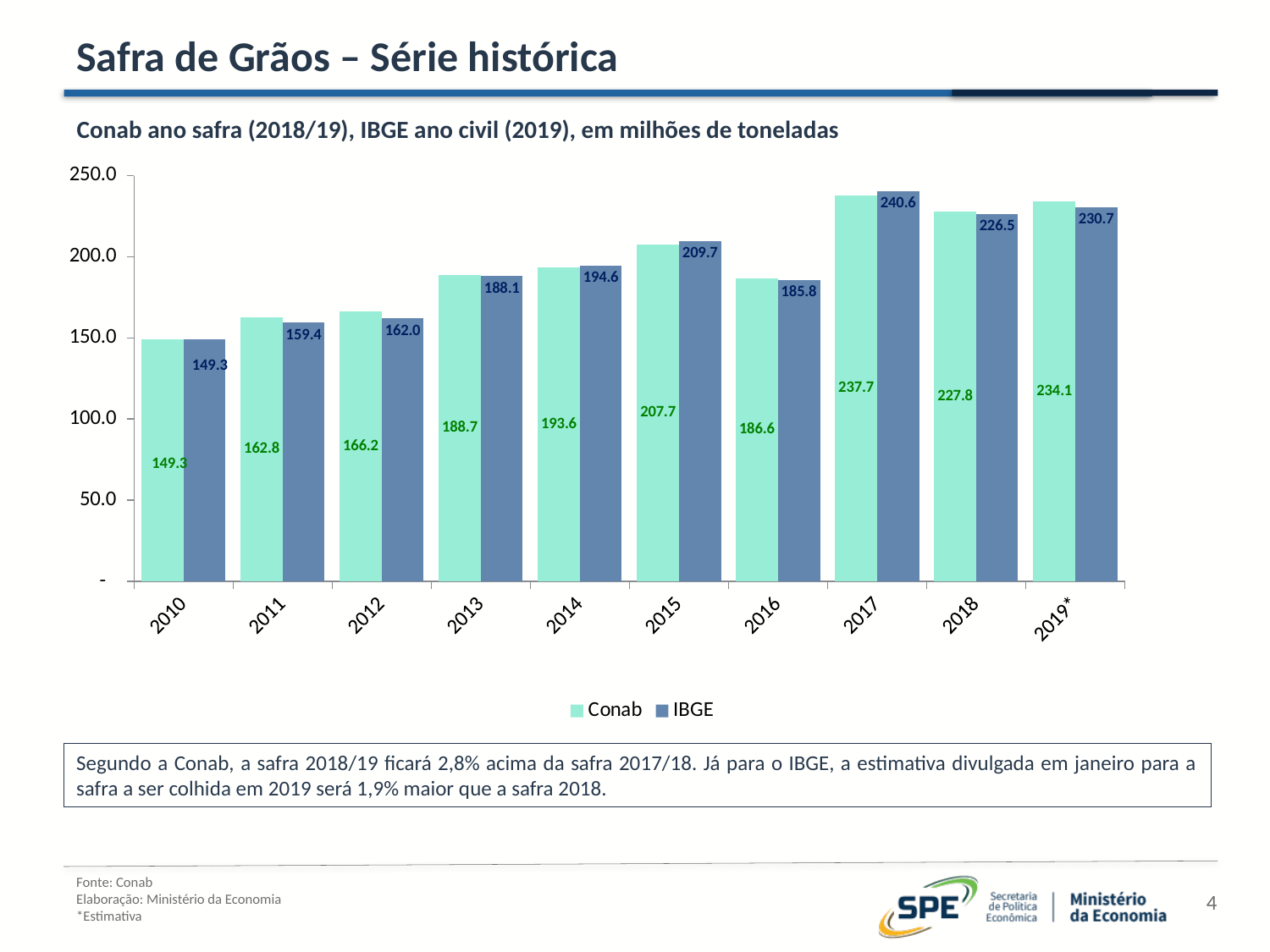
Which is larger, the Conab value for 2018 or the IBGE value for 2018? Conab (227.8) Is the IBGE value for 2013 greater or less than 150.0? greater What kind of chart is shown on the slide? Bar chart How many series does the legend list? 2 What is the IBGE value for 2015? 209.7 Which year has the highest IBGE value? 2017 What is the Conab value for 2017? 237.7 Which series is shown in dark blue in the legend? IBGE What is the difference between the Conab values for 2017 and 2016? 51.1 Which year has the lowest Conab value? 2010 How many years are shown on the x axis? 10 What is the IBGE value for 2019*? 230.7